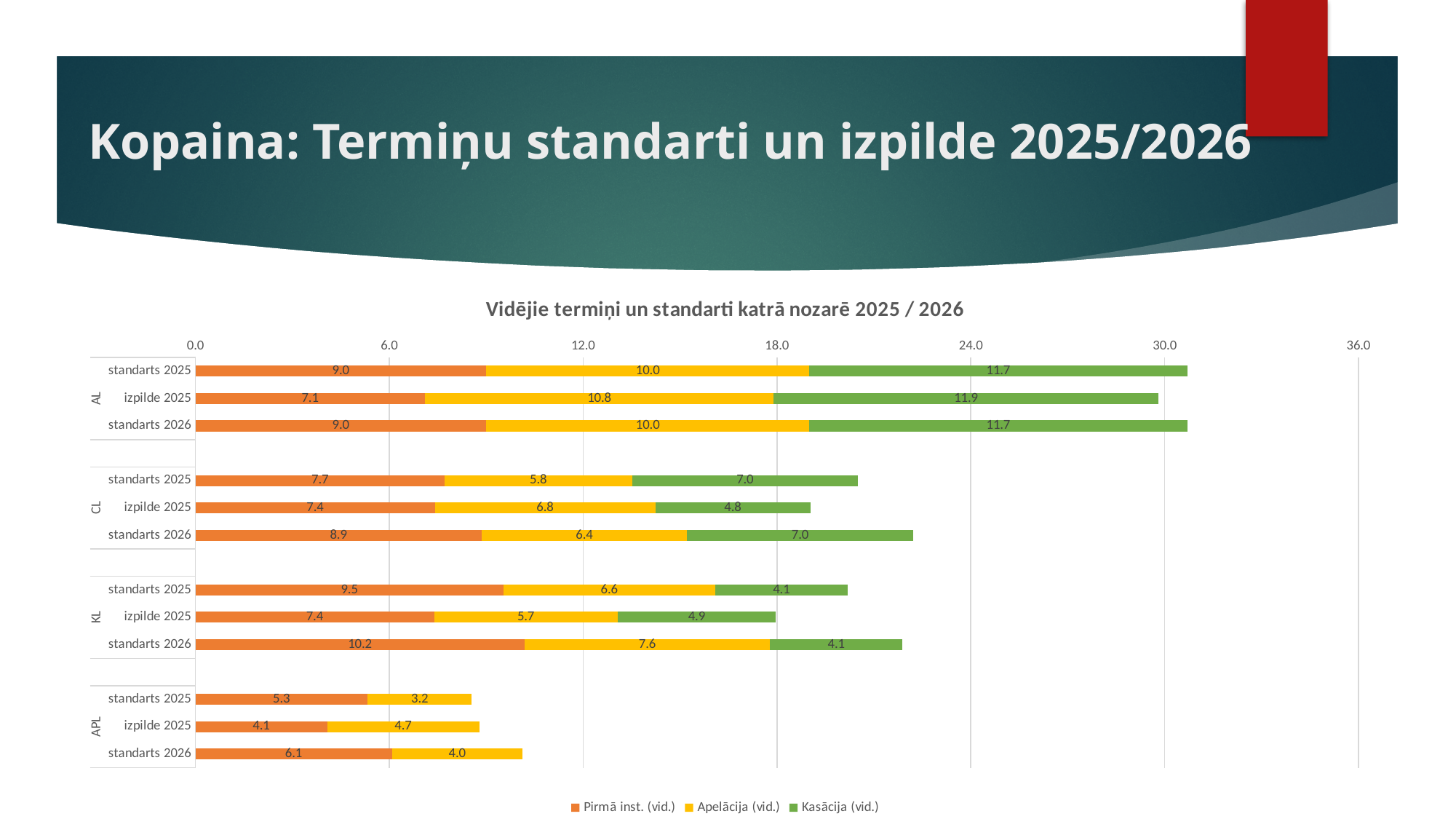
What is the Pirmā inst. (vid.) value for AL izpilde 2025? 7.1 How many series does the legend list? 3 Which row has the highest Pirmā inst. (vid.) value? KL standarts 2026 How many sector groups (AL, CL, KL, APL) are shown on the vertical axis? 4 What is the Kasācija (vid.) value for CL izpilde 2025? 4.8 What is the difference between the Pirmā inst. (vid.) values for KL standarts 2026 and KL izpilde 2025? 2.8 Which row has the lowest Apelācija (vid.) value? APL standarts 2025 What is the total of the stacked bar for APL izpilde 2025? 8.8 What kind of chart is shown on the slide? Stacked bar chart What is the total of the stacked bar for AL standarts 2025? 30.7 What is the Apelācija (vid.) value for KL standarts 2026? 7.6 Which has the larger Kasācija (vid.) value: AL izpilde 2025 or AL standarts 2025? AL izpilde 2025